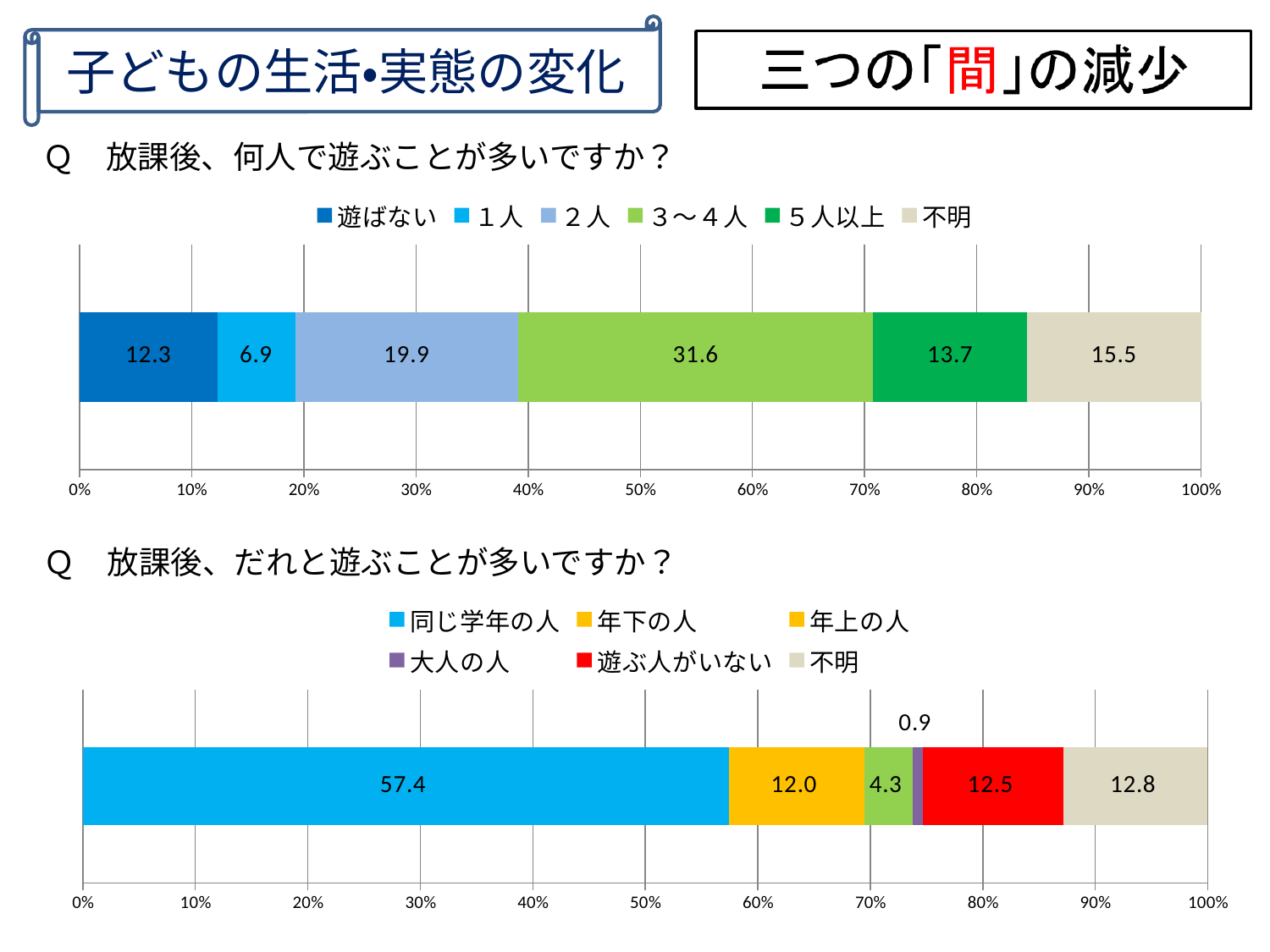
In the top chart (放課後、何人で遊ぶことが多いですか？), how many series does the legend list? 6 In the bottom chart (放課後、だれと遊ぶことが多いですか？), what is the value for 大人の人? 0.9 In the bottom chart (放課後、だれと遊ぶことが多いですか？), which is larger, the value for 不明 or the value for 年下の人? 不明 In the top chart (放課後、何人で遊ぶことが多いですか？), which category has the largest value? 3～4人 In the bottom chart (放課後、だれと遊ぶことが多いですか？), is the value for 同じ学年の人 greater or less than 50%? greater In the top chart (放課後、何人で遊ぶことが多いですか？), what is the value for 3～4人? 31.6 In the top chart (放課後、何人で遊ぶことが多いですか？), what is the value for 遊ばない? 12.3 What kind of chart is the top chart (放課後、何人で遊ぶことが多いですか？)? Stacked bar chart In the bottom chart (放課後、だれと遊ぶことが多いですか？), what is the value for 同じ学年の人? 57.4 In the bottom chart (放課後、だれと遊ぶことが多いですか？), what is the value for 遊ぶ人がいない? 12.5 In the top chart (放課後、何人で遊ぶことが多いですか？), which category has the smallest value? 1人 In the top chart (放課後、何人で遊ぶことが多いですか？), what is the difference between the values for 2人 and 1人? 13.0